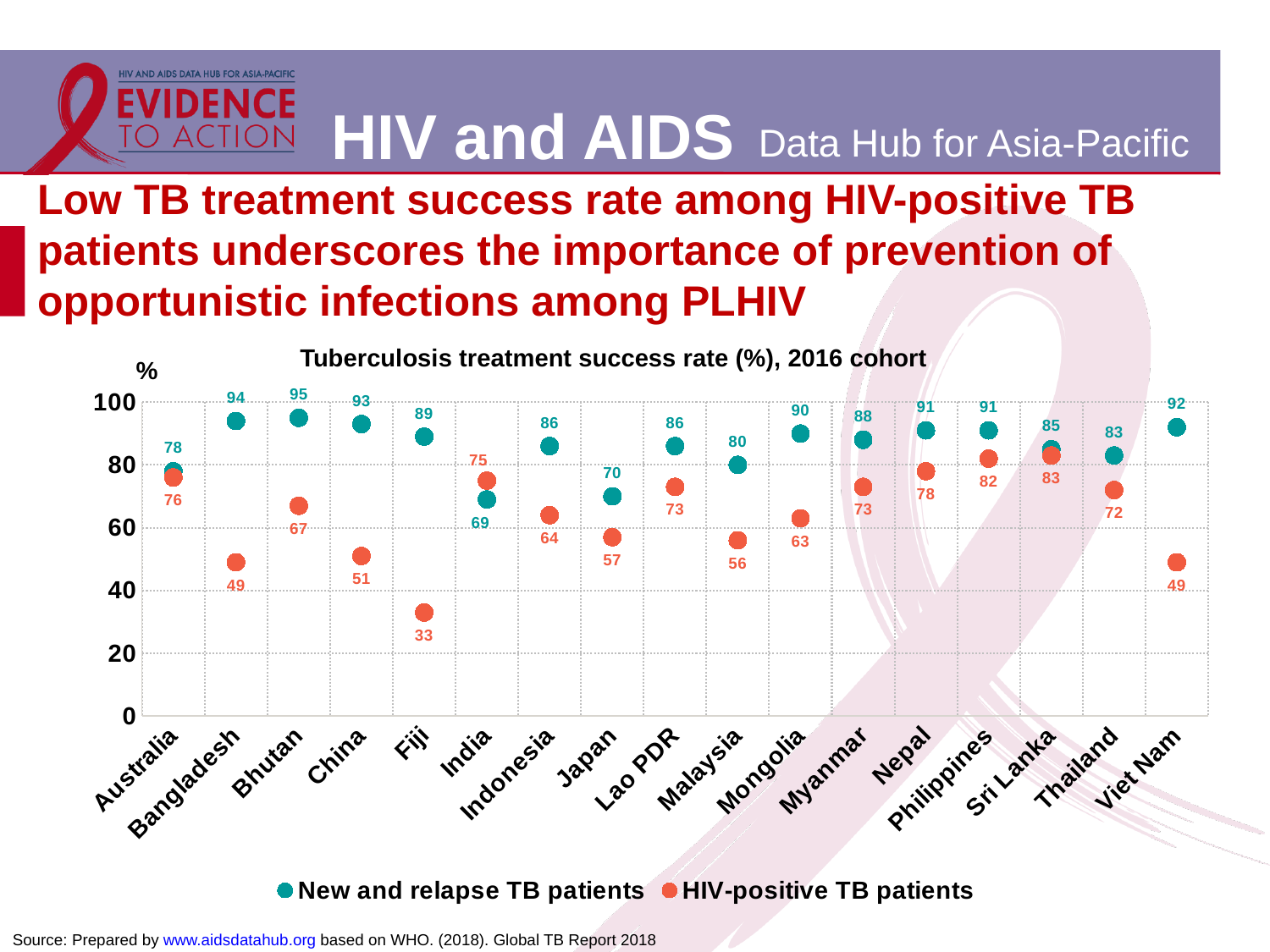
Which country has the lowest treatment success rate among new and relapse TB patients? India What is the title of the chart? Tuberculosis treatment success rate (%), 2016 cohort How many countries are shown on the x axis of the chart? 17 What kind of chart is used to show the tuberculosis treatment success rates? Scatter (dot) chart In India, which group has the higher treatment success rate: new and relapse TB patients or HIV-positive TB patients? HIV-positive TB patients What is the difference between the success rates for new and relapse TB patients and HIV-positive TB patients in Fiji? 56 What is the difference between the success rates for new and relapse TB patients and HIV-positive TB patients in Viet Nam? 43 Which country has the lowest treatment success rate among HIV-positive TB patients? Fiji What is the tuberculosis treatment success rate for new and relapse TB patients in Bhutan? 95 Which country has the highest treatment success rate among new and relapse TB patients? Bhutan How many series does the legend list? 2 What is the tuberculosis treatment success rate for HIV-positive TB patients in Fiji? 33